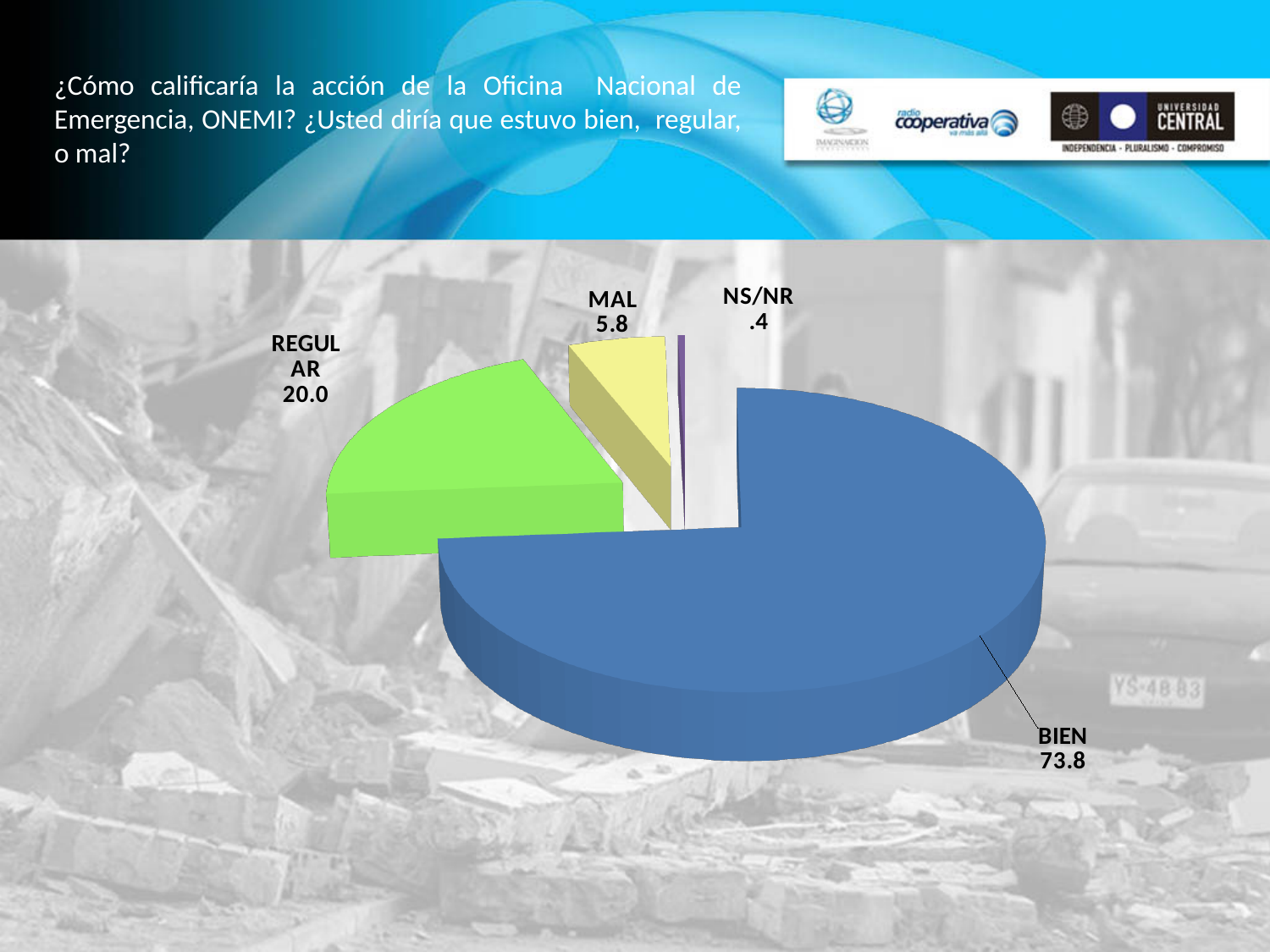
What is the value for MAL? 5.8 Which is larger, the value for MAL or the value for NS/NR? MAL How many slices does the pie chart have? 4 What colour is the BIEN slice of the pie? blue What is the value for NS/NR? .4 Which category has the largest slice of the pie? BIEN What is the difference between the values for BIEN and REGULAR? 53.8 Which category has the smallest slice of the pie? NS/NR What is the value for BIEN? 73.8 What kind of chart is shown on the slide? pie chart What is the value for REGULAR? 20.0 What is the difference between the values for REGULAR and MAL? 14.2